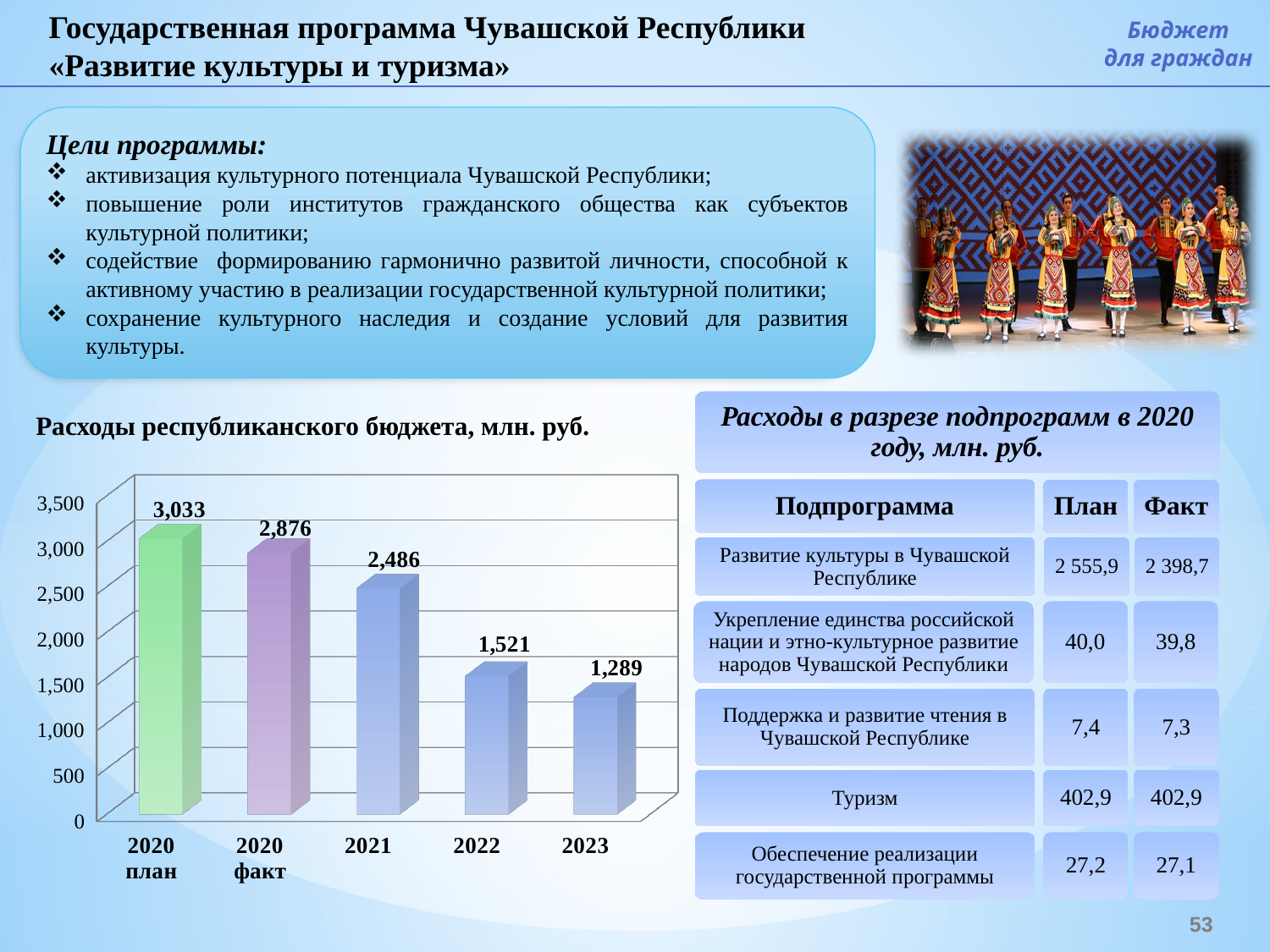
What is the value for 2020 факт in the chart 'Расходы республиканского бюджета, млн. руб.'? 2,876 Is the value for 2022 in the chart 'Расходы республиканского бюджета, млн. руб.' greater or less than 2,000? less How many bars are shown in the chart 'Расходы республиканского бюджета, млн. руб.'? 5 What is the difference between the 2020 план and 2020 факт values in the chart 'Расходы республиканского бюджета, млн. руб.'? 157 What is the value for 2020 план in the chart 'Расходы республиканского бюджета, млн. руб.'? 3,033 Do the values in the chart 'Расходы республиканского бюджета, млн. руб.' rise or fall from 2020 план to 2023? fall What is the difference between the 2021 and 2022 values in the chart 'Расходы республиканского бюджета, млн. руб.'? 965 In the chart 'Расходы республиканского бюджета, млн. руб.', which is larger: the value for 2021 or the value for 2022? 2021 Which category has the highest value in the chart 'Расходы республиканского бюджета, млн. руб.'? 2020 план What is the value for 2023 in the chart 'Расходы республиканского бюджета, млн. руб.'? 1,289 What kind of chart is 'Расходы республиканского бюджета, млн. руб.'? bar chart Which category has the lowest value in the chart 'Расходы республиканского бюджета, млн. руб.'? 2023